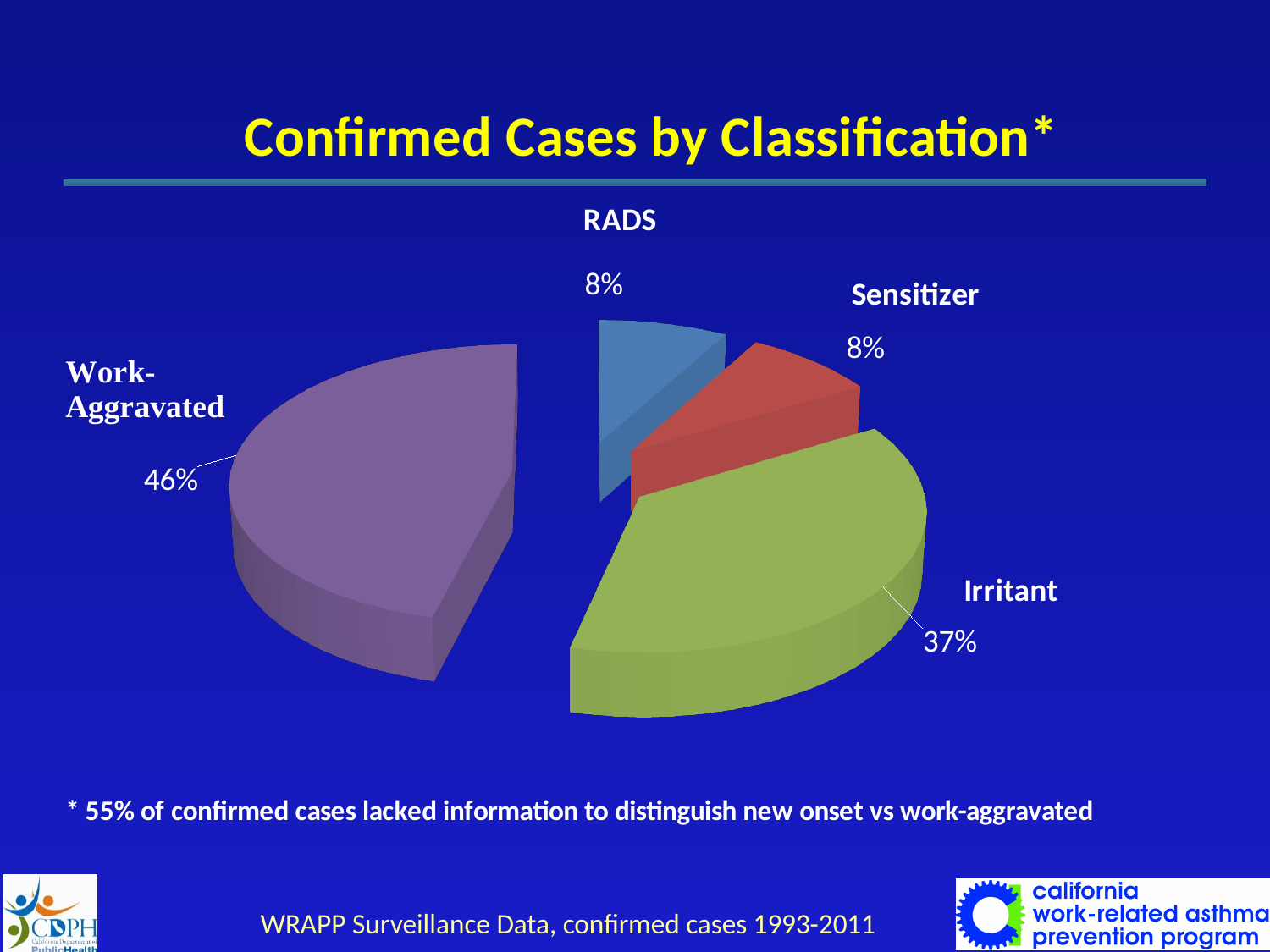
What is the title of the chart? Confirmed Cases by Classification* What kind of chart is shown on the slide? Pie chart What share of confirmed cases is classified as Sensitizer? 8% What share of confirmed cases is classified as Work-Aggravated? 46% How many categories (slices) does the pie chart have? 4 What share of confirmed cases is classified as RADS? 8% Which classification has the largest share of confirmed cases? Work-Aggravated What is the difference in percentage points between the Irritant share and the RADS share? 29 percentage points What is the difference in percentage points between the Work-Aggravated share and the Irritant share? 9 percentage points Which is larger, the share for Irritant or the share for Work-Aggravated? Work-Aggravated Which is larger, the share for Irritant or the share for Sensitizer? Irritant